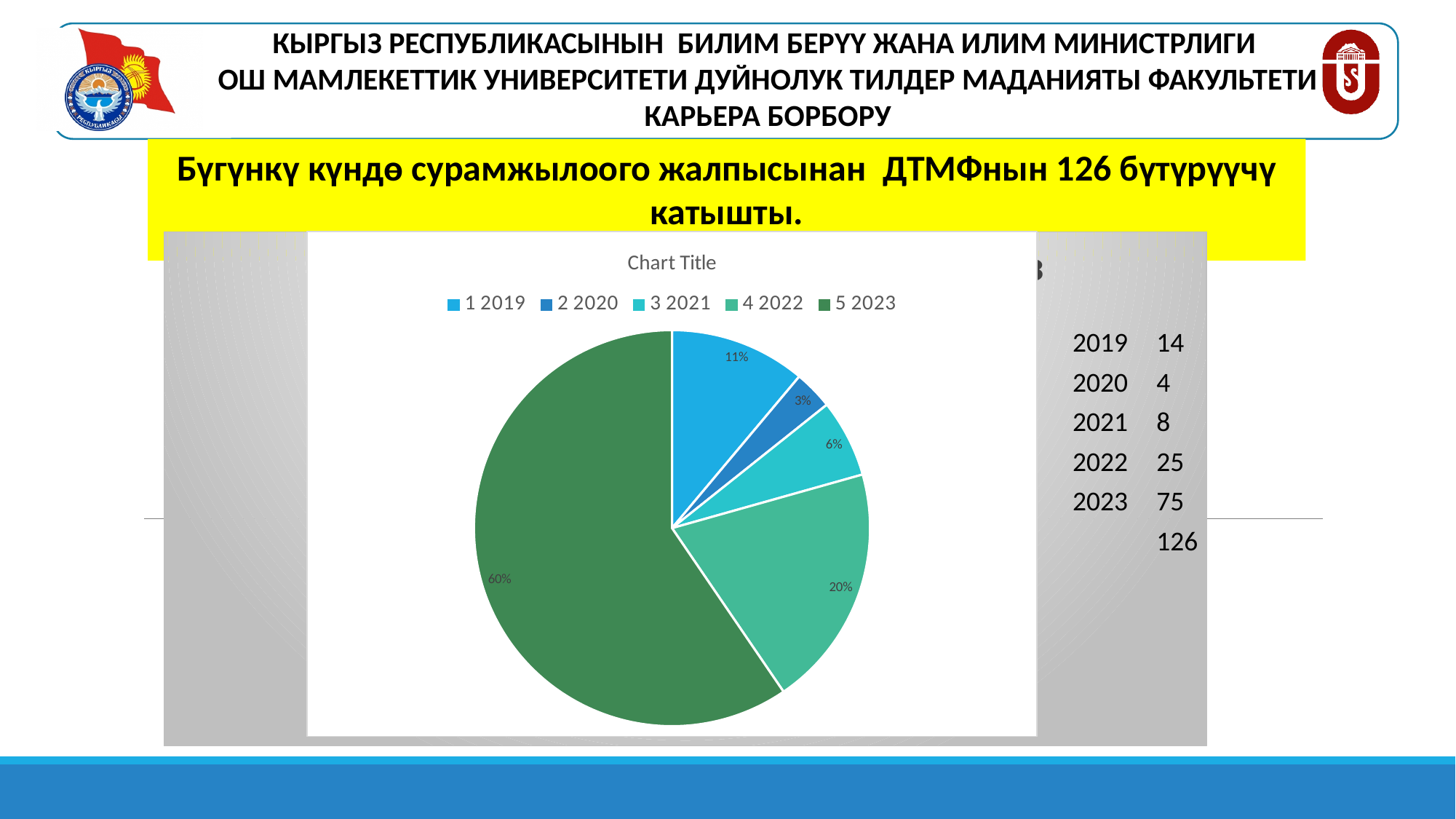
What is the difference in percentage points between the 5 2023 slice and the 4 2022 slice? 40 Which slice of the pie chart is the smallest? 2 2020 Which slice is larger, 3 2021 or 4 2022? 4 2022 What percentage is shown for the slice labelled 4 2022? 20% What percentage is shown for the slice labelled 5 2023? 60% What kind of chart is shown on the slide? pie chart How many entries does the chart legend list? 5 What percentage is shown for the slice labelled 1 2019? 11% What is the title of the chart? Chart Title What percentage is shown for the slice labelled 2 2020? 3% Which slice of the pie chart is the largest? 5 2023 How many slices does the pie chart have? 5